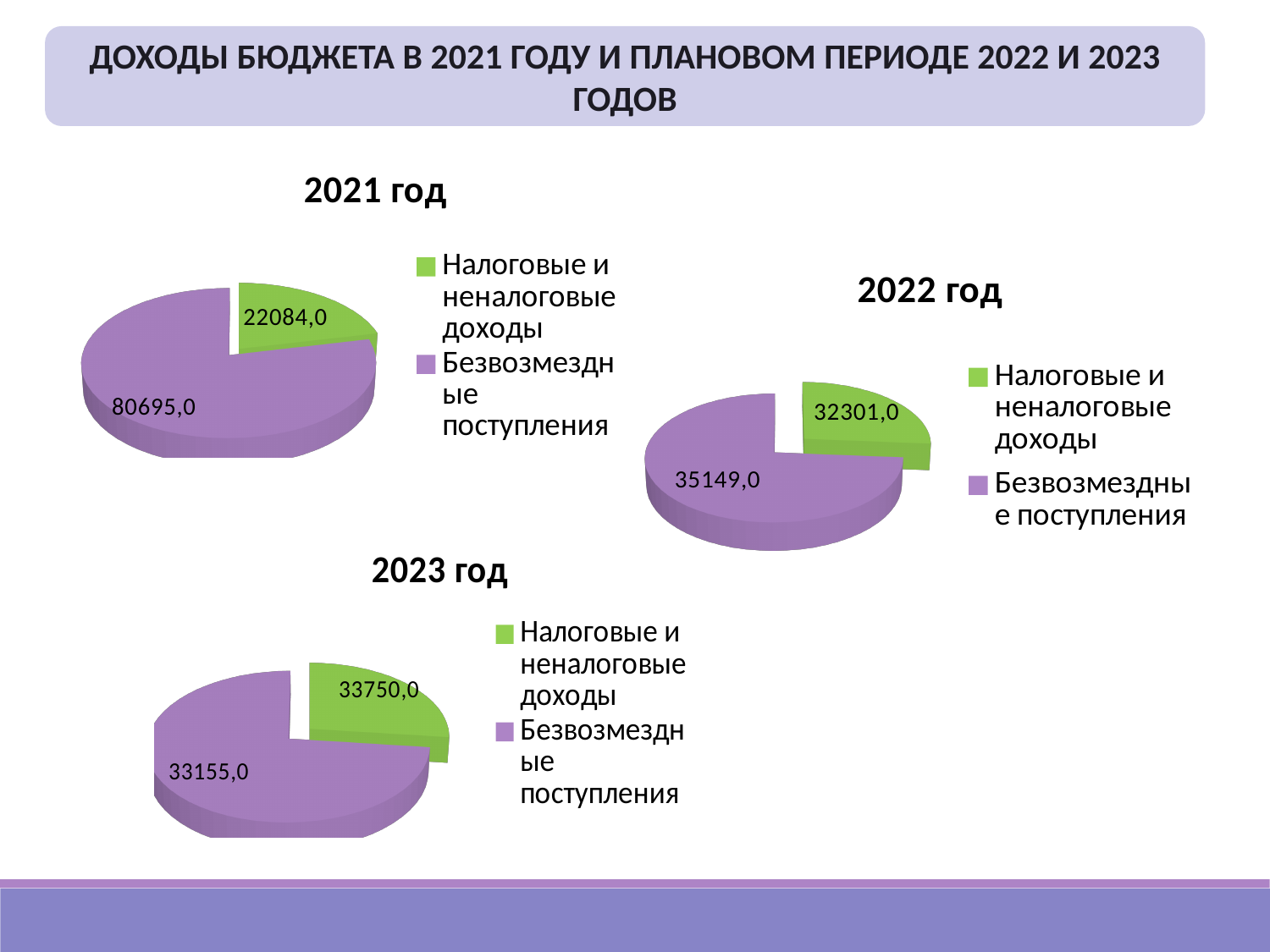
What kind of chart is the 2023 год chart? pie chart In the 2022 год chart, is the value for Безвозмездные поступления larger or smaller than the value for Налоговые и неналоговые доходы? larger In the 2021 год chart, which category has the largest slice? Безвозмездные поступления In the 2022 год chart, which category has the smaller slice? Налоговые и неналоговые доходы In the 2022 год chart, what is the value for Налоговые и неналоговые доходы? 32301,0 In the 2022 год chart, what is the difference between Безвозмездные поступления and Налоговые и неналоговые доходы? 2848,0 In the 2021 год chart, what is the value for Налоговые и неналоговые доходы? 22084,0 In the 2021 год chart, what is the value for Безвозмездные поступления? 80695,0 In the 2021 год chart, what is the difference between Безвозмездные поступления and Налоговые и неналоговые доходы? 58611,0 In the 2023 год chart, what is the value for Безвозмездные поступления? 33155,0 How many charts are shown on the slide? 3 How many slices does the 2022 год chart have? 2